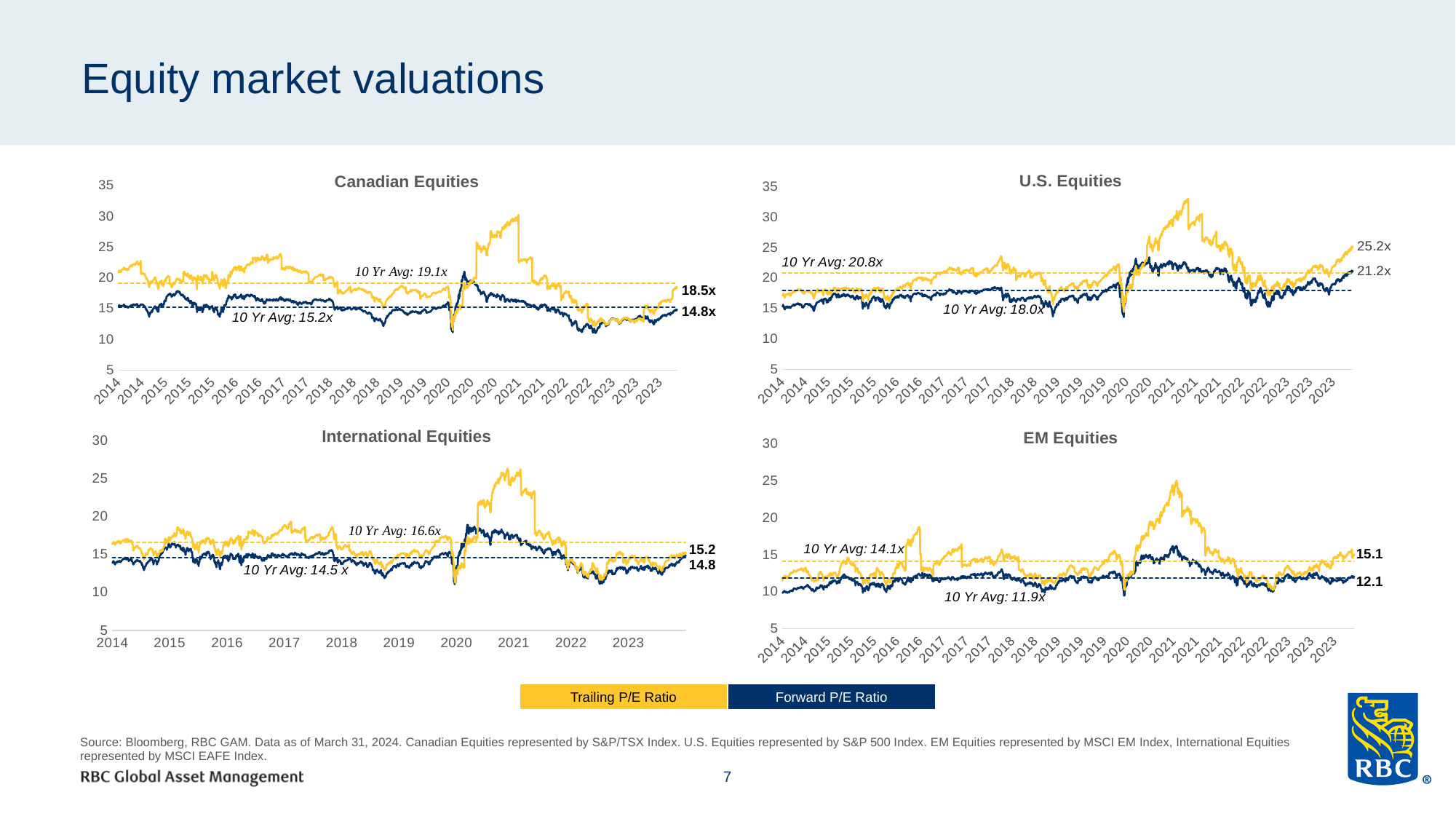
On the EM Equities chart, what is the 10-year average trailing P/E ratio shown? 14.1x Across the four charts, which market has the highest latest trailing P/E ratio? U.S. Equities On the U.S. Equities chart, what is the latest forward P/E ratio value labelled at the end of the line? 21.2x On the Canadian Equities chart, what is the latest trailing P/E ratio value labelled at the end of the line? 18.5x On the U.S. Equities chart, is the peak of the trailing P/E ratio in 2021 greater or less than 30? greater On the EM Equities chart, what is the difference between the latest trailing P/E (15.1) and the latest forward P/E (12.1)? 3.0 How many series does the shared legend list for the charts? 2 On the U.S. Equities chart, what is the difference between the latest trailing P/E (25.2x) and the latest forward P/E (21.2x)? 4.0x On the Canadian Equities chart, which is larger: the latest trailing P/E of 18.5x or the 10-year average trailing P/E of 19.1x? The 10-year average (19.1x) On the International Equities chart, what is the 10-year average forward P/E ratio shown? 14.5x According to the legend, which colour represents the Trailing P/E Ratio? Yellow What kind of chart is the International Equities chart? Line chart